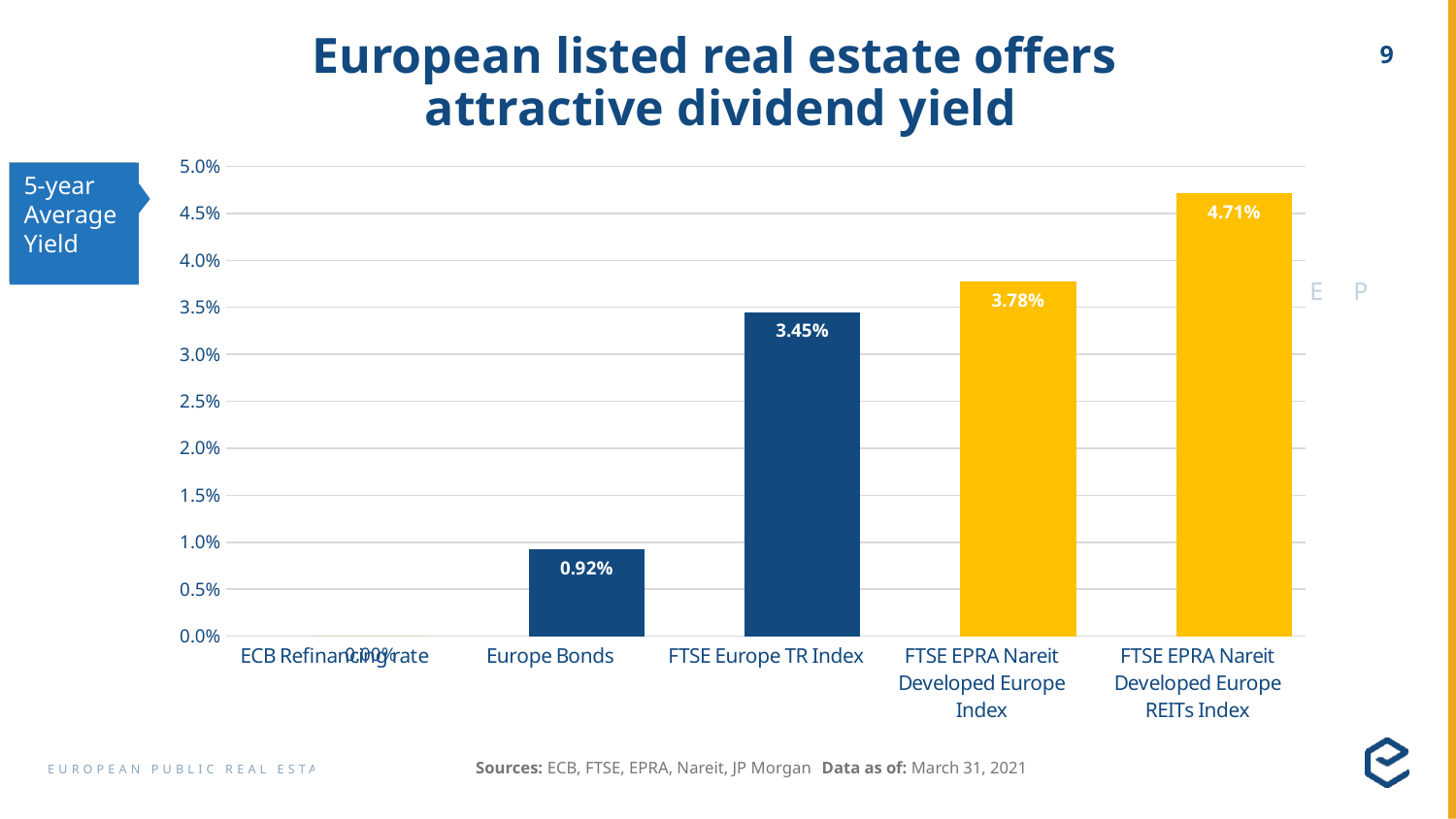
Is the value for the FTSE EPRA Nareit Developed Europe REITs Index greater or less than 4.5%? greater Which category has the highest 5-year average yield? FTSE EPRA Nareit Developed Europe REITs Index Which category has the lowest 5-year average yield? ECB Refinancing rate What is the 5-year average yield for Europe Bonds? 0.92% What kind of chart is shown on the slide? Bar chart What is the difference in yield between the FTSE EPRA Nareit Developed Europe REITs Index and the FTSE EPRA Nareit Developed Europe Index? 0.93% How many categories are shown on the chart? 5 Which has a higher 5-year average yield, Europe Bonds or the FTSE Europe TR Index? FTSE Europe TR Index What is the difference in yield between the FTSE EPRA Nareit Developed Europe Index and the FTSE Europe TR Index? 0.33% What is the 5-year average yield for the FTSE EPRA Nareit Developed Europe Index? 3.78% What is the 5-year average yield for the FTSE Europe TR Index? 3.45% What is the 5-year average yield for the FTSE EPRA Nareit Developed Europe REITs Index? 4.71%